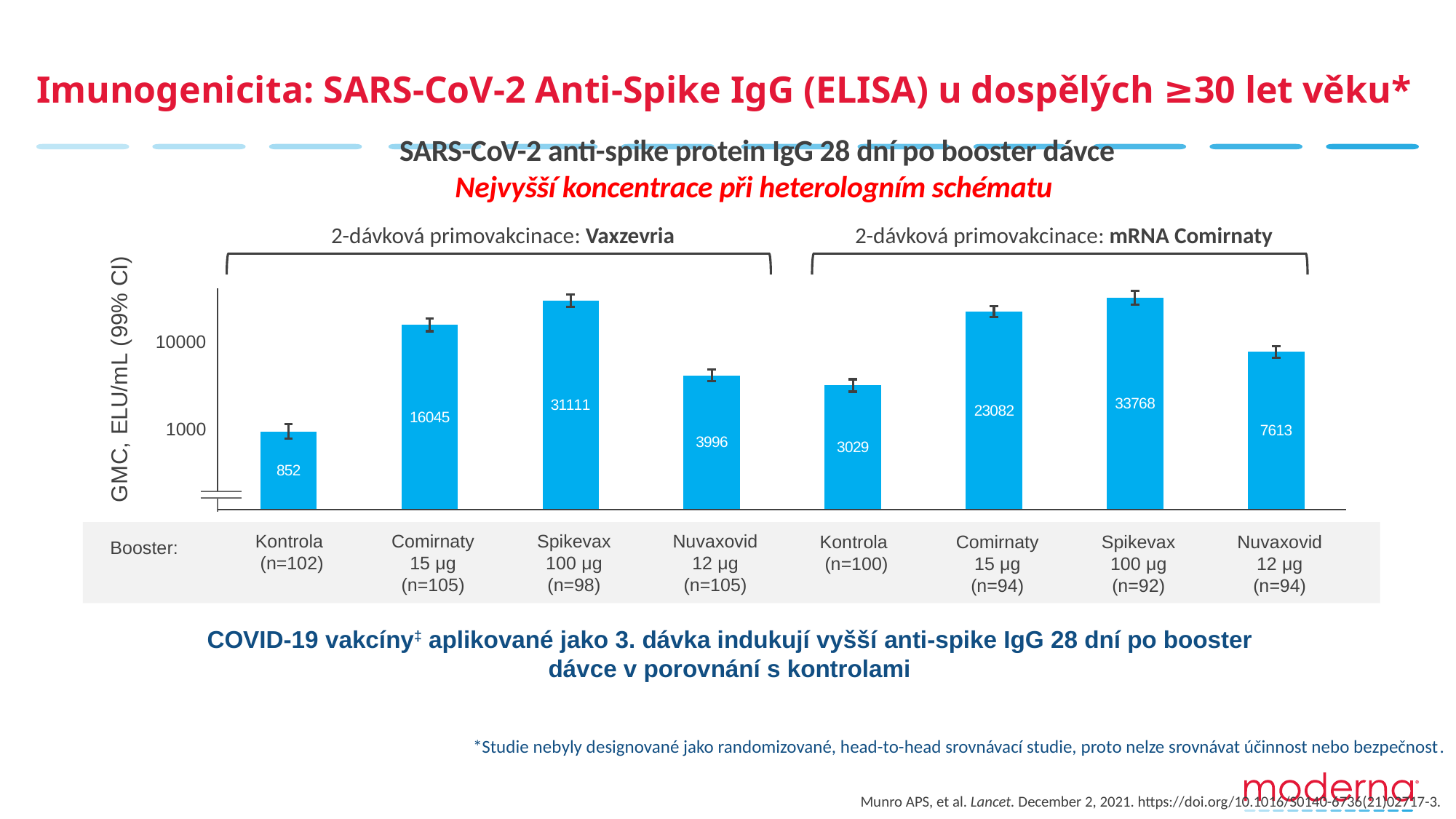
Which is larger: the Nuvaxovid booster GMC after Vaxzevria primary vaccination or after mRNA Comirnaty primary vaccination? After mRNA Comirnaty primary vaccination What is the GMC value for the Kontrola (control) group after mRNA Comirnaty primary vaccination? 3029 Is the GMC value for the Kontrola group after Vaxzevria primary vaccination greater or less than 1000? less What is the difference between the Spikevax and Comirnaty booster GMC values in the mRNA Comirnaty primary vaccination group? 10686 What is the difference between the Comirnaty booster GMC value and the Kontrola value in the Vaxzevria primary vaccination group? 15193 Which bar has the lowest GMC value on the chart? Kontrola (Vaxzevria primary vaccination) What is the GMC value for the Nuvaxovid 12 µg booster in the mRNA Comirnaty primary vaccination group? 7613 How many bars are plotted on the chart? 8 What is the GMC value for the Spikevax 100 µg booster in the Vaxzevria primary vaccination group? 31111 Which booster has the highest GMC value across the whole chart? Spikevax 100 µg (mRNA Comirnaty primary vaccination) What is the label of the y-axis of the chart? GMC, ELU/mL (99% CI) What type of chart is shown on the slide? Bar chart